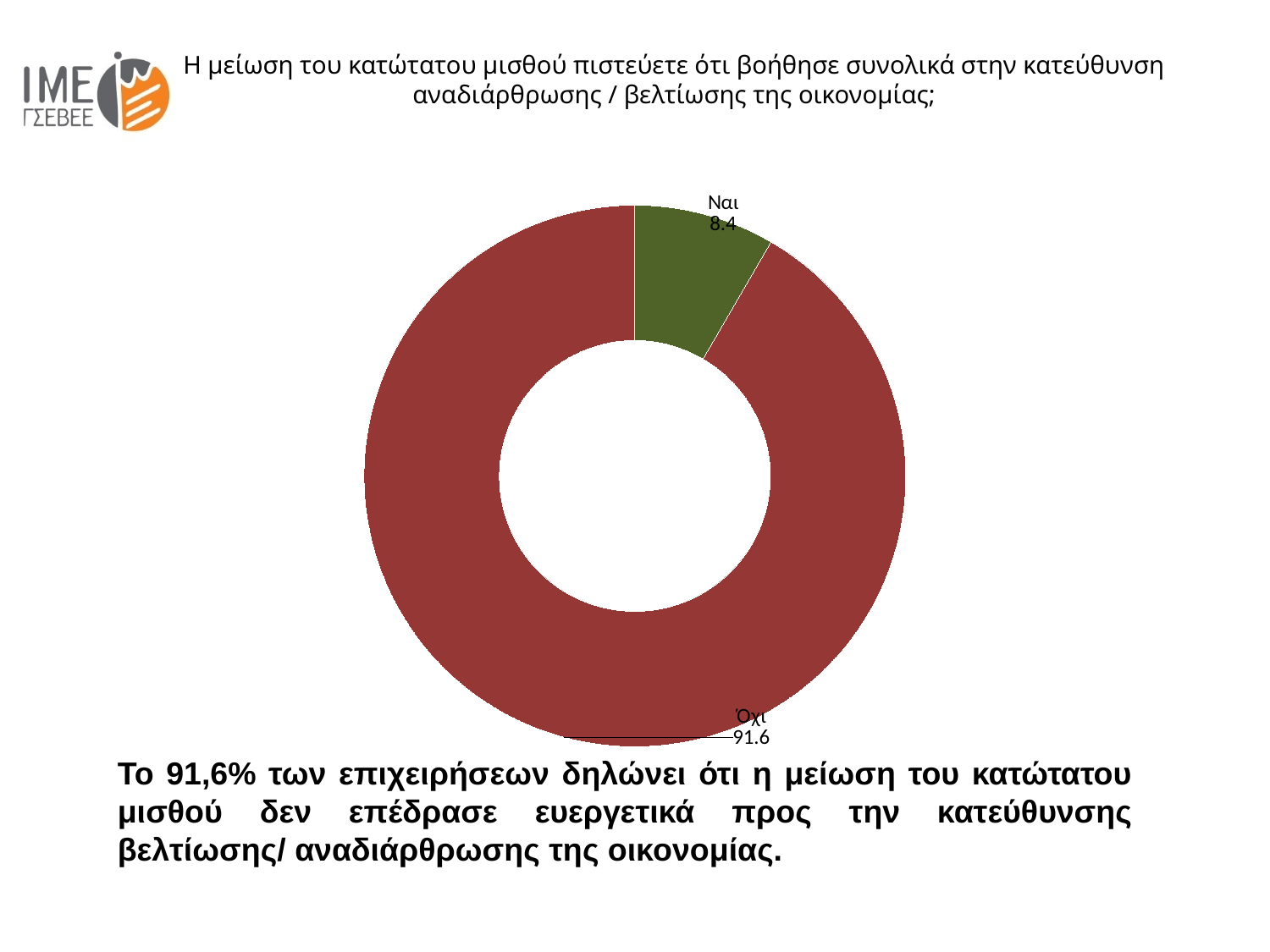
How many categories are shown in the chart? 2 What value is shown for the "Όχι" slice? 91.6 What value is shown for the "Ναι" slice? 8.4 What is the total of the two values shown in the chart? 100 What kind of chart is shown on the slide? Doughnut chart What colour is the "Ναι" slice? Green Which category has the smallest slice? Ναι What is the difference between the values for "Όχι" and "Ναι"? 83.2 What colour is the "Όχι" slice? Red Which category has the largest slice? Όχι Which is larger, the value for "Ναι" or the value for "Όχι"? Όχι